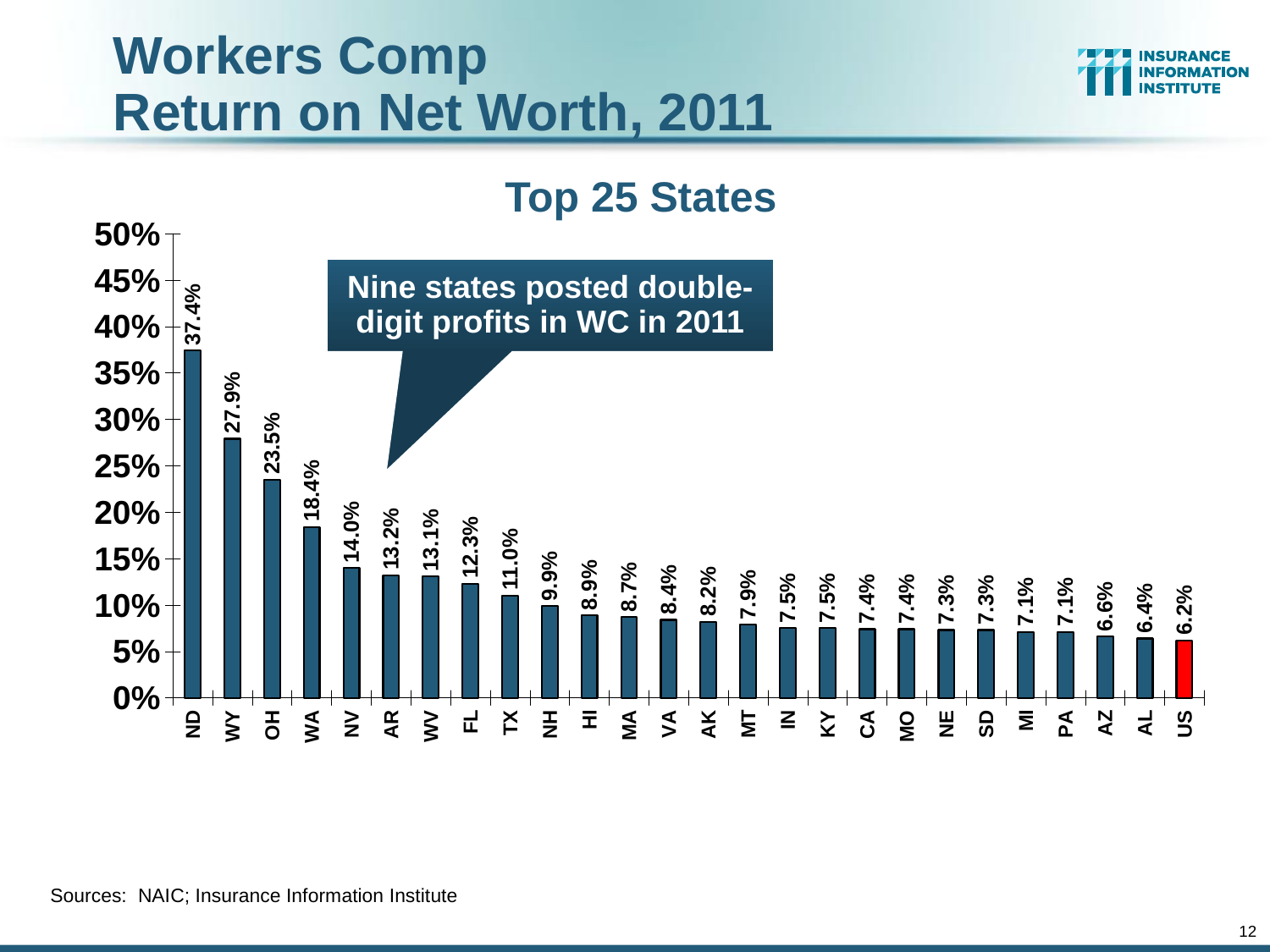
Which category has the lowest value on the chart? US Which has a higher return on net worth, OH or WA? OH Which category has the highest return on net worth? ND Which bar is coloured red instead of blue? US What is the return on net worth for the US bar? 6.2% Do the values rise or fall moving from left to right along the x axis? Fall How many bars are plotted on the chart? 26 What is the return on net worth for ND? 37.4% What is the difference between the values for ND and WY? 9.5% Is the value for NV greater or less than 10%? greater What is the value shown for TX? 11.0% What kind of chart is shown on the slide? Bar chart